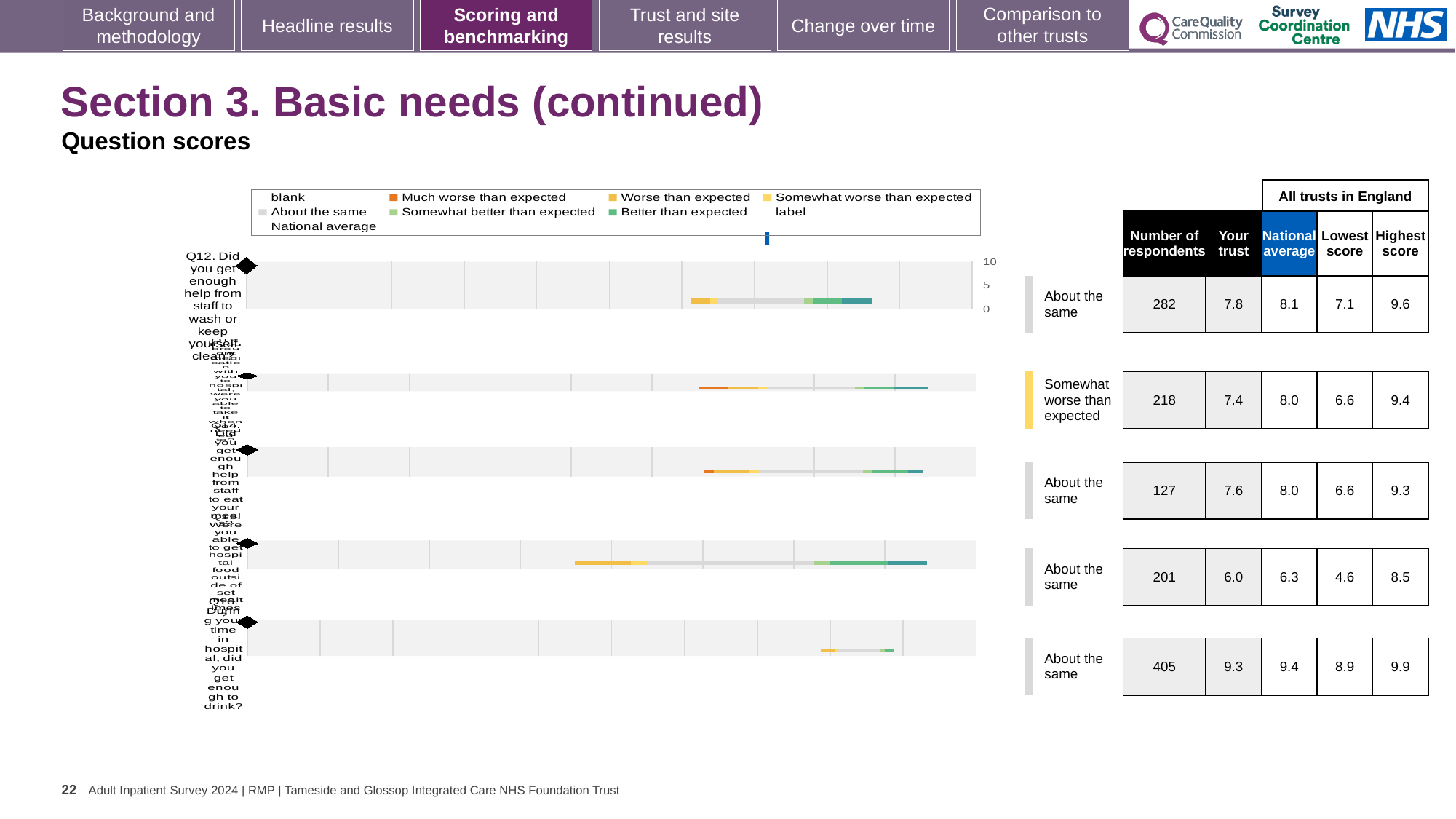
How many entries does the chart legend list? 9 For the first chart (Q12), what is the difference between the highest score and the lowest score across all trusts in England? 2.5 In the chart legend, what colour represents 'Somewhat worse than expected'? yellow Which benchmark category is shown for the second chart row (Q13)? Somewhat worse than expected How many question charts (rows) are shown on the slide? 5 Which chart row has the lowest 'Your trust' score? Q15 (fourth row), 6.0 What kind of chart is used to show the benchmark bands for each question on this slide? bar chart For the first chart (Q12, help from staff to wash or keep yourself clean), what is the number of respondents shown? 282 For the fifth chart (Q16, did you get enough to drink), what is the national average score? 9.4 Which chart row has the highest 'Your trust' score? Q16 (fifth row), 9.3 For the first chart (Q12, help from staff to wash or keep yourself clean), what is the 'Your trust' score? 7.8 In the chart legend, what colour represents 'Much worse than expected'? orange